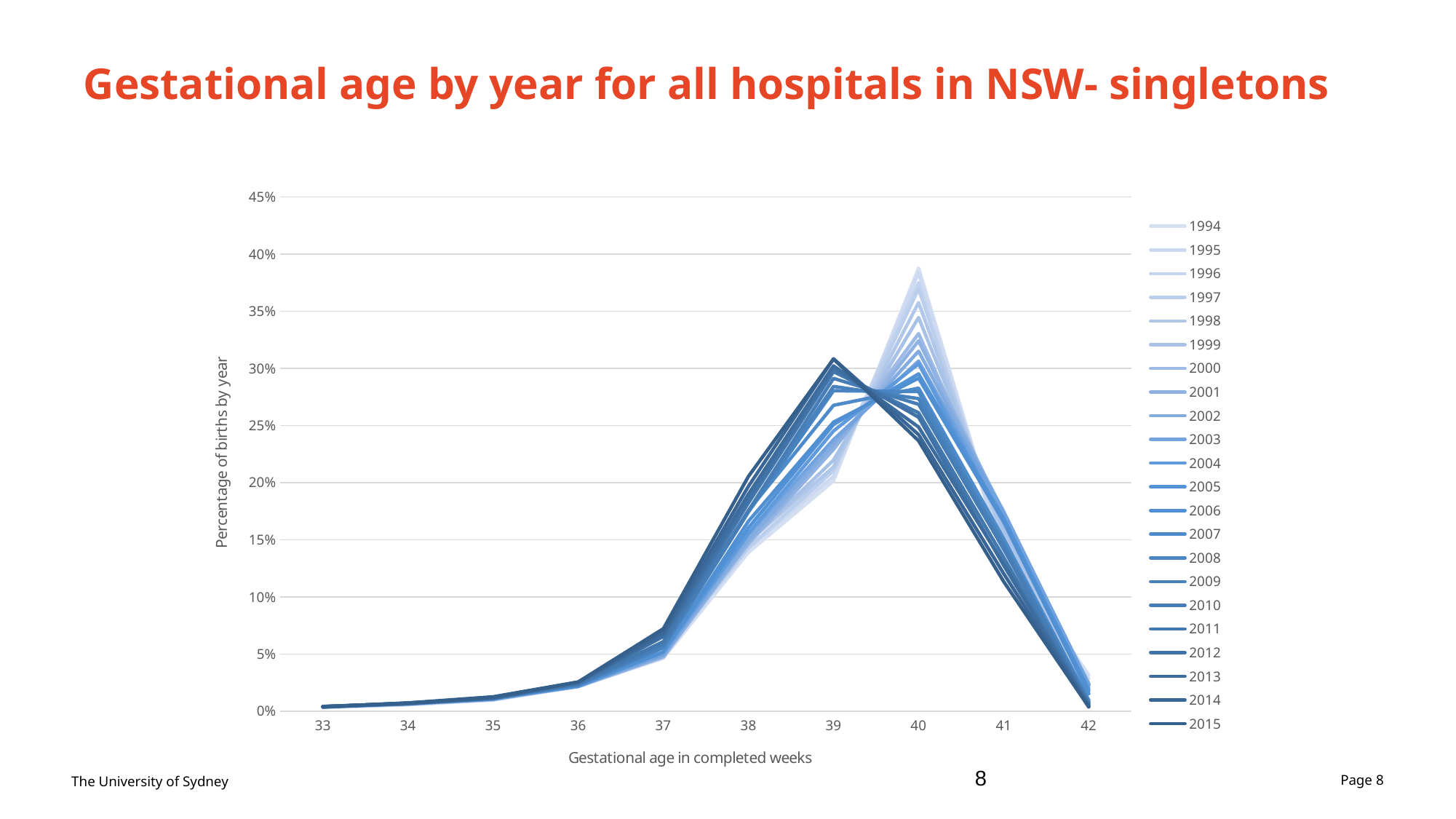
Which gestational age has the lowest values across all years? 33 Is the value for 33 weeks greater or less than 5%? less What is the label of the y axis? Percentage of births by year Do the values rise or fall along the x axis from 40 weeks to 42 weeks? fall How many series does the legend list? 22 How many gestational age categories are shown on the x axis? 10 What kind of chart is shown on the slide? Line chart Do the values rise or fall along the x axis from 33 weeks to 39 weeks? rise Is the value for 41 weeks greater or less than 10%? greater What is the title of the chart? Gestational age by year for all hospitals in NSW- singletons Is the value for 42 weeks greater or less than 5%? less